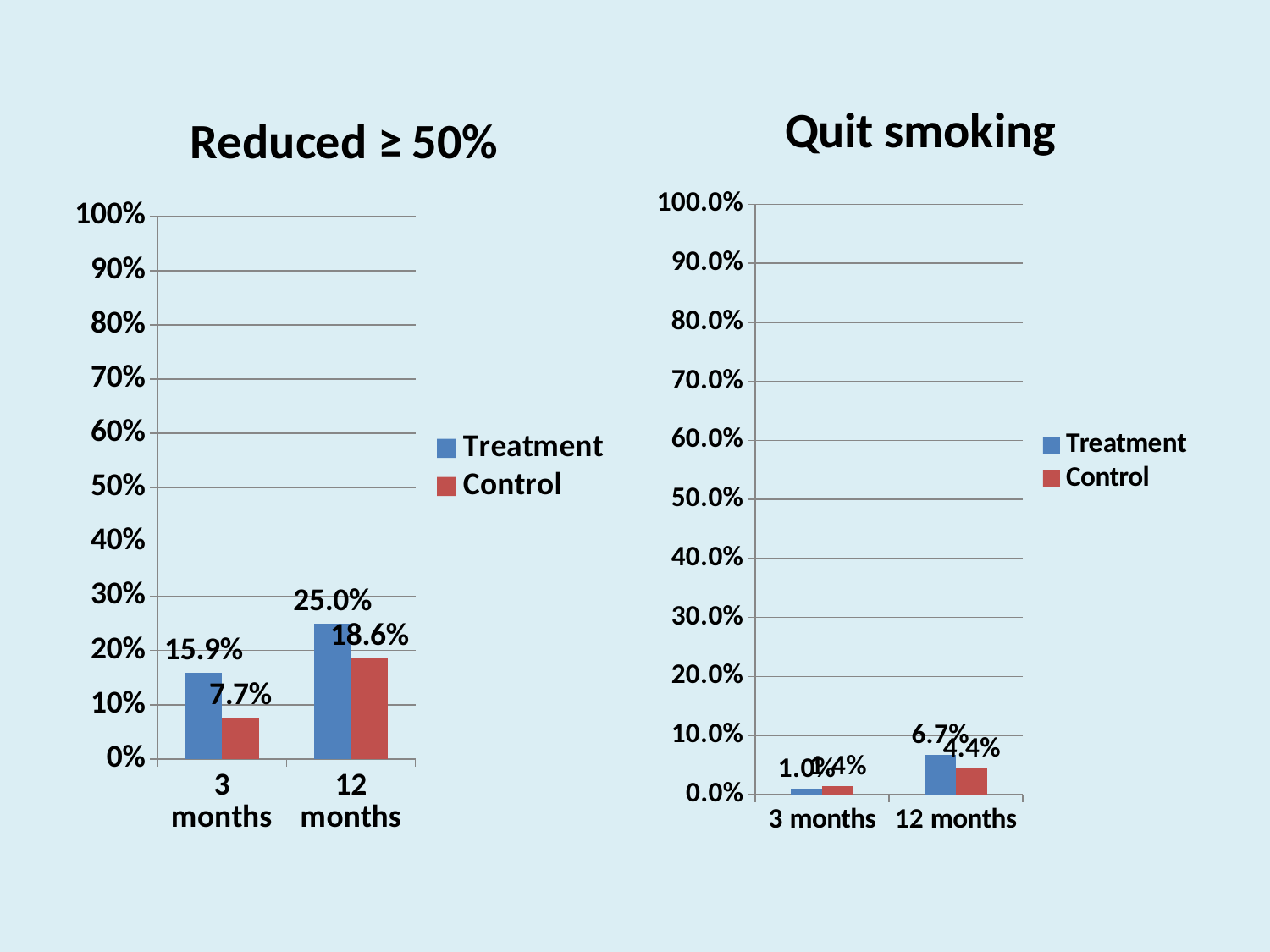
How many series does the legend of the 'Reduced ≥ 50%' chart list? 2 In the 'Quit smoking' chart, does the Treatment value rise or fall from 3 months to 12 months? rise In the 'Reduced ≥ 50%' chart, what is the value for Treatment at 3 months? 15.9% In the 'Reduced ≥ 50%' chart, what is the difference between Treatment and Control at 3 months? 8.2% In the 'Quit smoking' chart, is the value for Treatment at 12 months greater or less than 10.0%? less In the 'Reduced ≥ 50%' chart, which is larger at 12 months, Treatment or Control? Treatment In the 'Reduced ≥ 50%' chart, what is the value for Control at 12 months? 18.6% In the 'Reduced ≥ 50%' chart, what is the value for Treatment at 12 months? 25.0% In the 'Quit smoking' chart, what is the value for Treatment at 12 months? 6.7% In the 'Reduced ≥ 50%' chart, what is the value for Control at 3 months? 7.7% In the 'Quit smoking' chart, what is the value for Control at 12 months? 4.4% What kind of chart is the 'Quit smoking' chart? bar chart